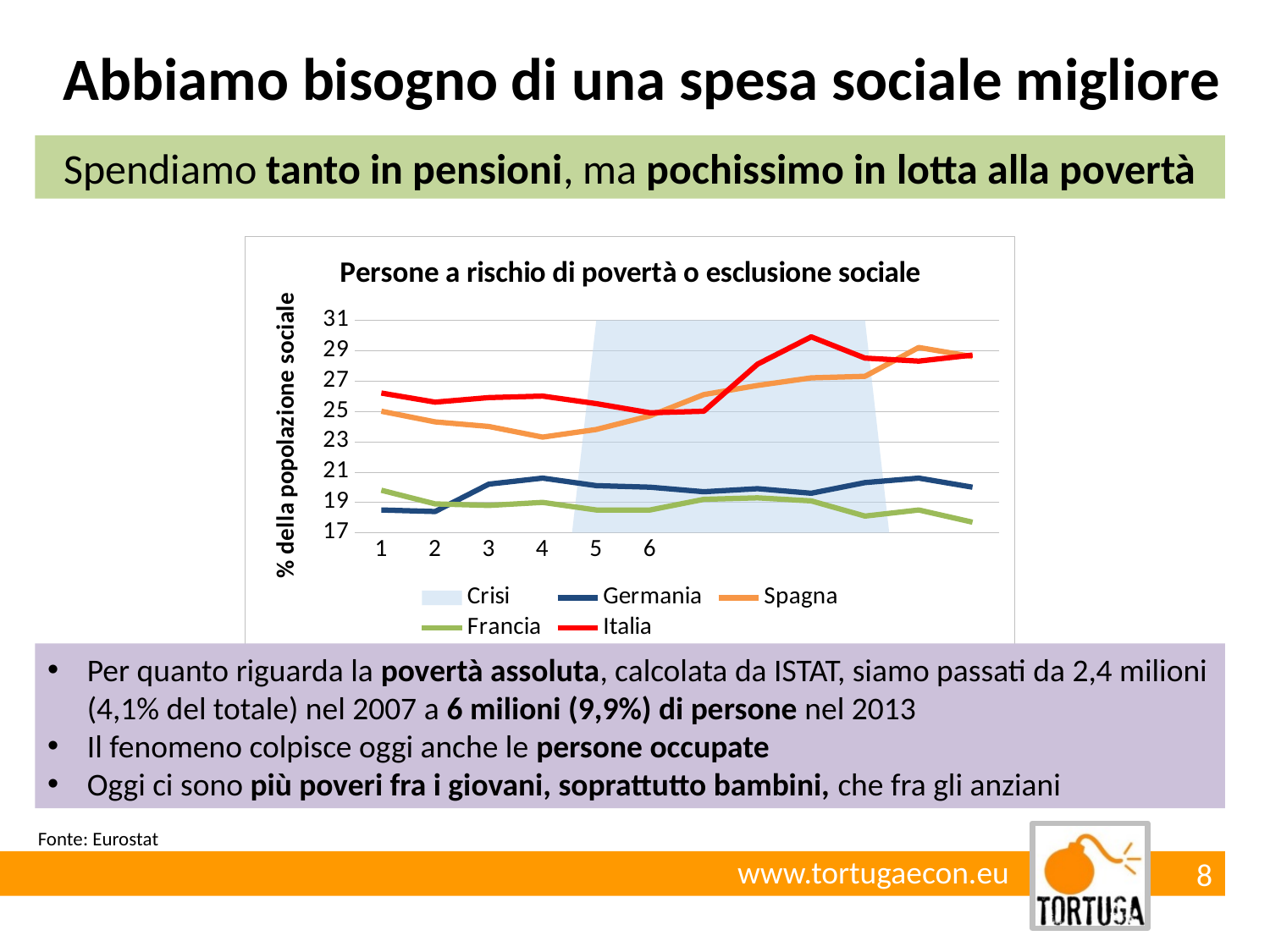
Is the highest value reached by the Germania line greater or less than 21? less How many entries does the chart legend list? 5 Does the Spagna line overall rise or fall from the first point to the last point? rise Which series has the highest value at x = 1? Italia Is the value for Spagna at x = 4 greater or less than 25? less Is the value for Germania at x = 1 greater or less than 19? less Which series has the lowest value at the last point on the chart? Francia At x = 1, which is larger: the value for Francia or the value for Germania? Francia What kind of chart is shown on the slide? line chart What is the label of the vertical axis of the chart? % della popolazione sociale What is the title of the chart? Persone a rischio di povertà o esclusione sociale